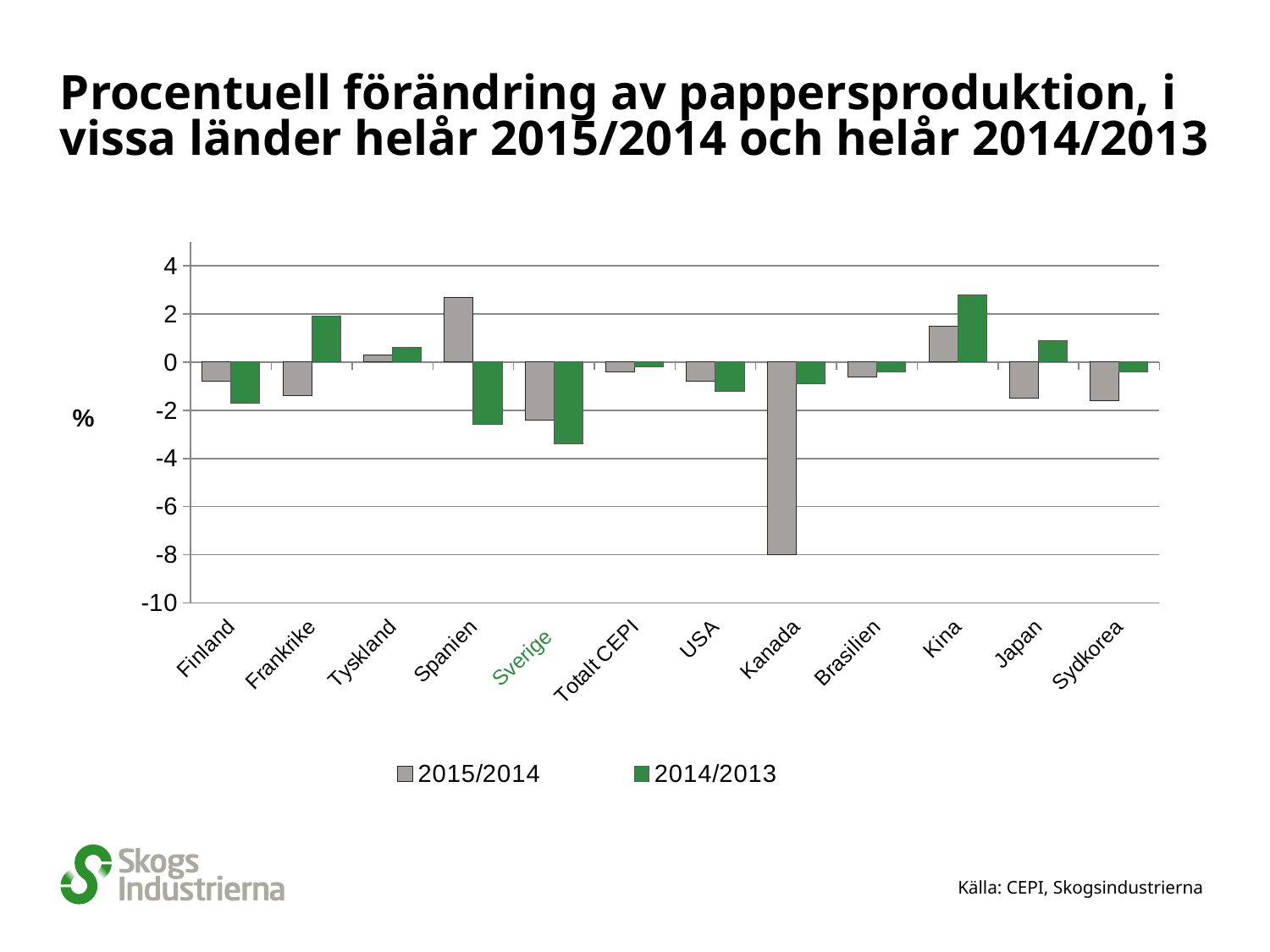
What are the two entries listed in the legend? 2015/2014 and 2014/2013 How many countries/categories are shown on the x axis? 12 Which category has the lowest value for the 2015/2014 series? Kanada Is the 2014/2013 value for Sverige greater or less than -2? less Is the 2015/2014 value for Spanien greater or less than 2? greater For Spanien, which series has the larger value, 2015/2014 or 2014/2013? 2015/2014 Is the 2015/2014 value for Kanada greater or less than -6? less Which category has the highest value for the 2014/2013 series? Kina Which category has the lowest value for the 2014/2013 series? Sverige How many series does the legend list? 2 What kind of chart is shown on the slide? bar chart Which category has the highest value for the 2015/2014 series? Spanien